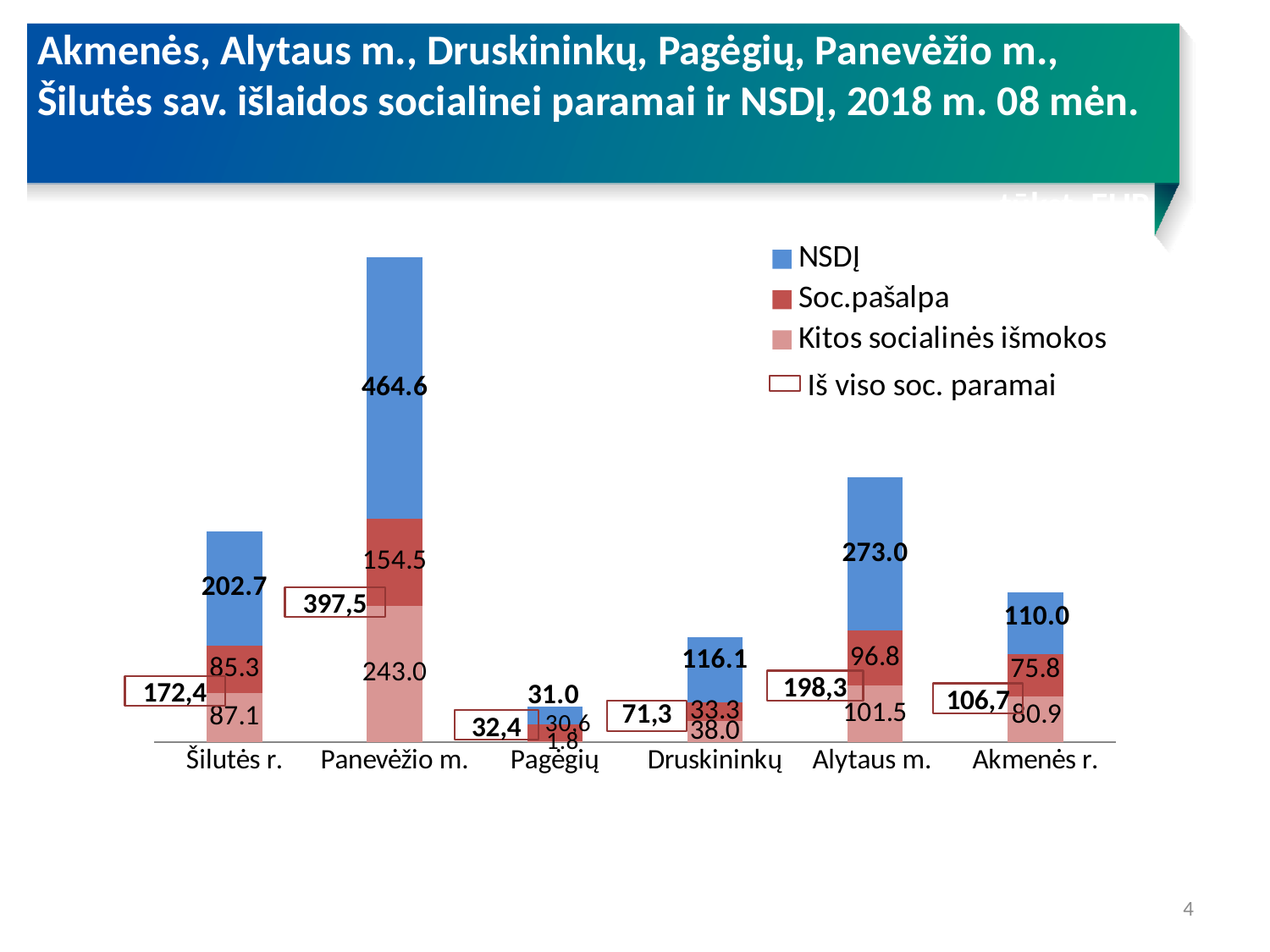
How many municipalities are shown on the x axis? 6 What is the difference between the NSDĮ values for Alytaus m. and Šilutės r.? 70.3 How many entries does the legend list? 4 Which has the larger Soc.pašalpa value, Šilutės r. or Akmenės r.? Šilutės r. What is the Iš viso soc. paramai value shown for Akmenės r.? 106,7 What kind of chart is shown on the slide? Stacked bar chart Which municipality has the highest NSDĮ value? Panevėžio m. What is the Kitos socialinės išmokos value for Druskininkų? 38.0 What is the NSDĮ value for Panevėžio m.? 464.6 Which municipality has the lowest Kitos socialinės išmokos value? Pagėgių What is the Soc.pašalpa value for Alytaus m.? 96.8 What colour represents NSDĮ in the legend? Blue